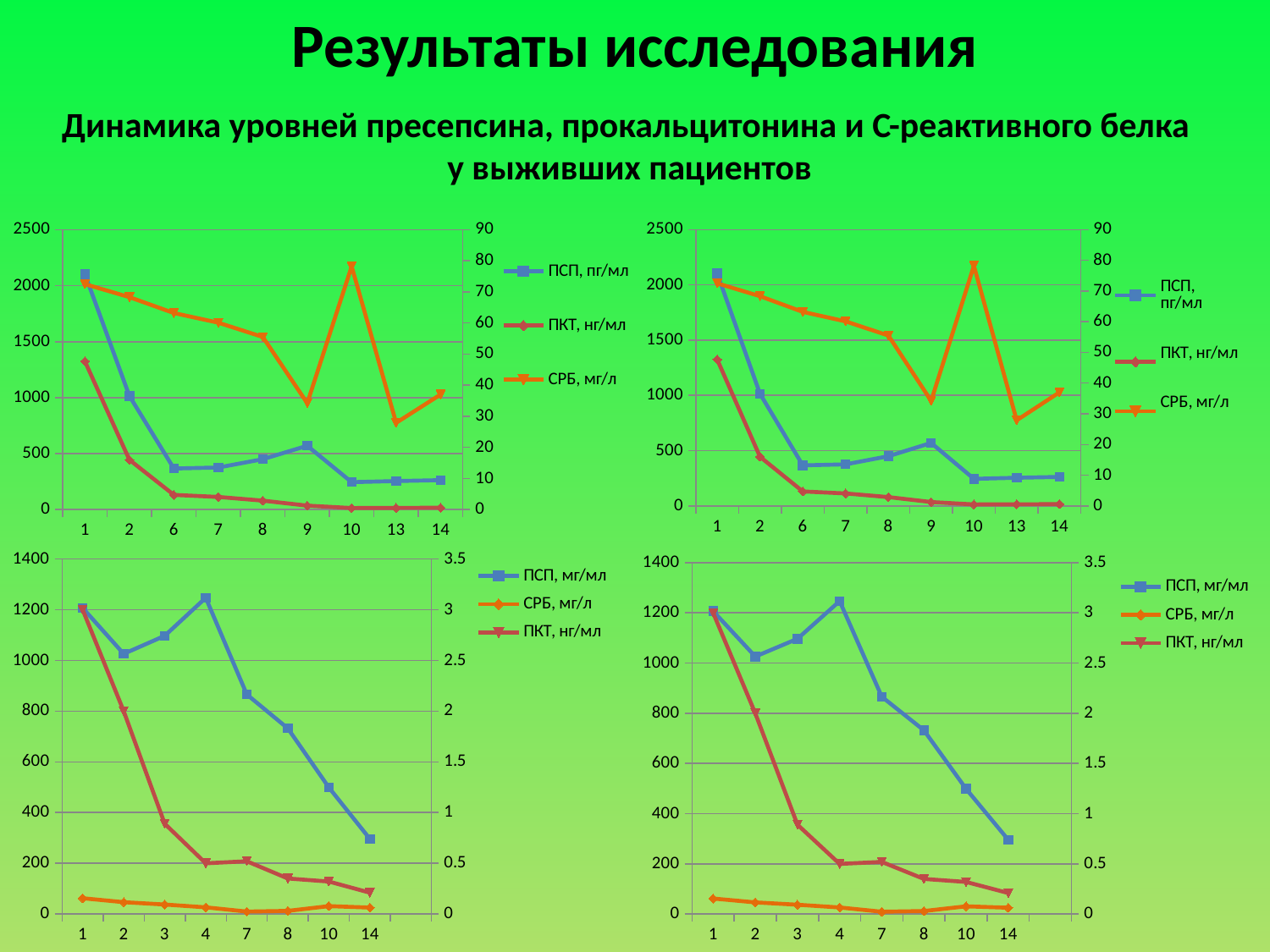
In the bottom-left chart, is the value of ПКТ, нг/мл at point 1 greater or less than 2.5? greater In the top-left chart, is the value of СРБ, мг/л at point 10 greater or less than 70? greater In the bottom-left chart, which is larger for ПСП, мг/мл: the value at point 1 or at point 2? point 1 In the top-left chart, does ПКТ, нг/мл rise or fall along the x axis? fall In the top-left chart, at which x-axis point is ПСП, пг/мл highest? 1 What kind of chart is the top-left chart? line chart How many x-axis points are plotted in the top-left chart? 9 In the top-left chart, is the value of ПСП, пг/мл at point 1 greater or less than 2000? greater How many series does the legend of the top-left chart list? 3 How many x-axis points are plotted in the bottom-left chart? 8